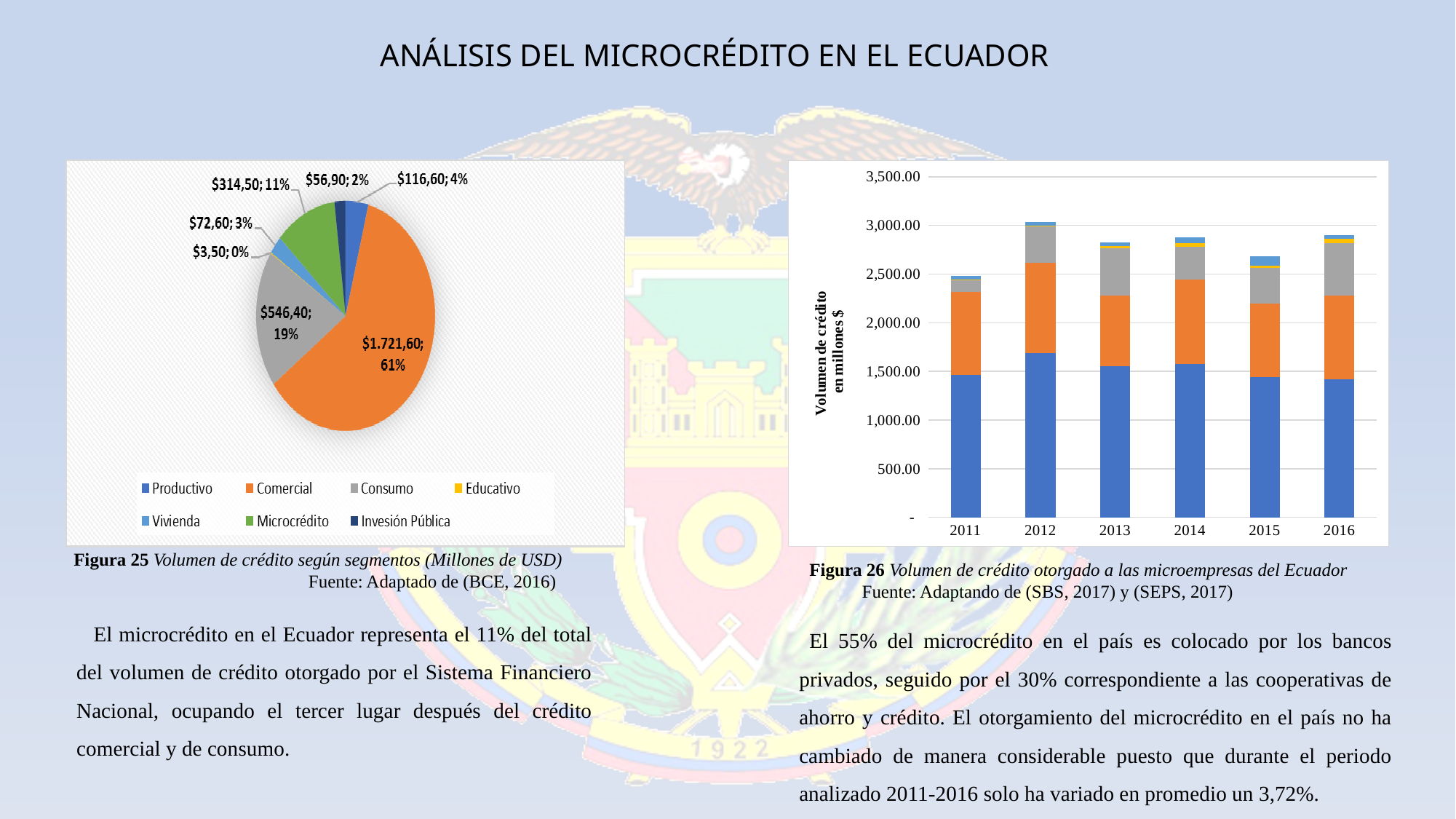
In the bar chart (Figura 26), which year has the tallest total bar? 2012 In the pie chart (Figura 25), what value and share are shown for Comercial? $1.721,60; 61% In the pie chart (Figura 25), what is the difference in percentage points between Consumo and Microcrédito? 8% In the pie chart (Figura 25), which segment has the largest share? Comercial In the pie chart (Figura 25), what value is shown for Consumo? $546,40 How many years are shown on the x axis of the bar chart (Figura 26)? 6 How many segments does the legend of the pie chart (Figura 25) list? 7 In the bar chart (Figura 26), is the total for 2015 greater or less than 3,000.00? less In the pie chart (Figura 25), which segment has the smallest share? Educativo In the pie chart (Figura 25), what share of the total does Microcrédito represent? 11% What kind of chart is Figura 26? Stacked bar chart In the pie chart (Figura 25), which is larger, Productivo or Vivienda? Productivo